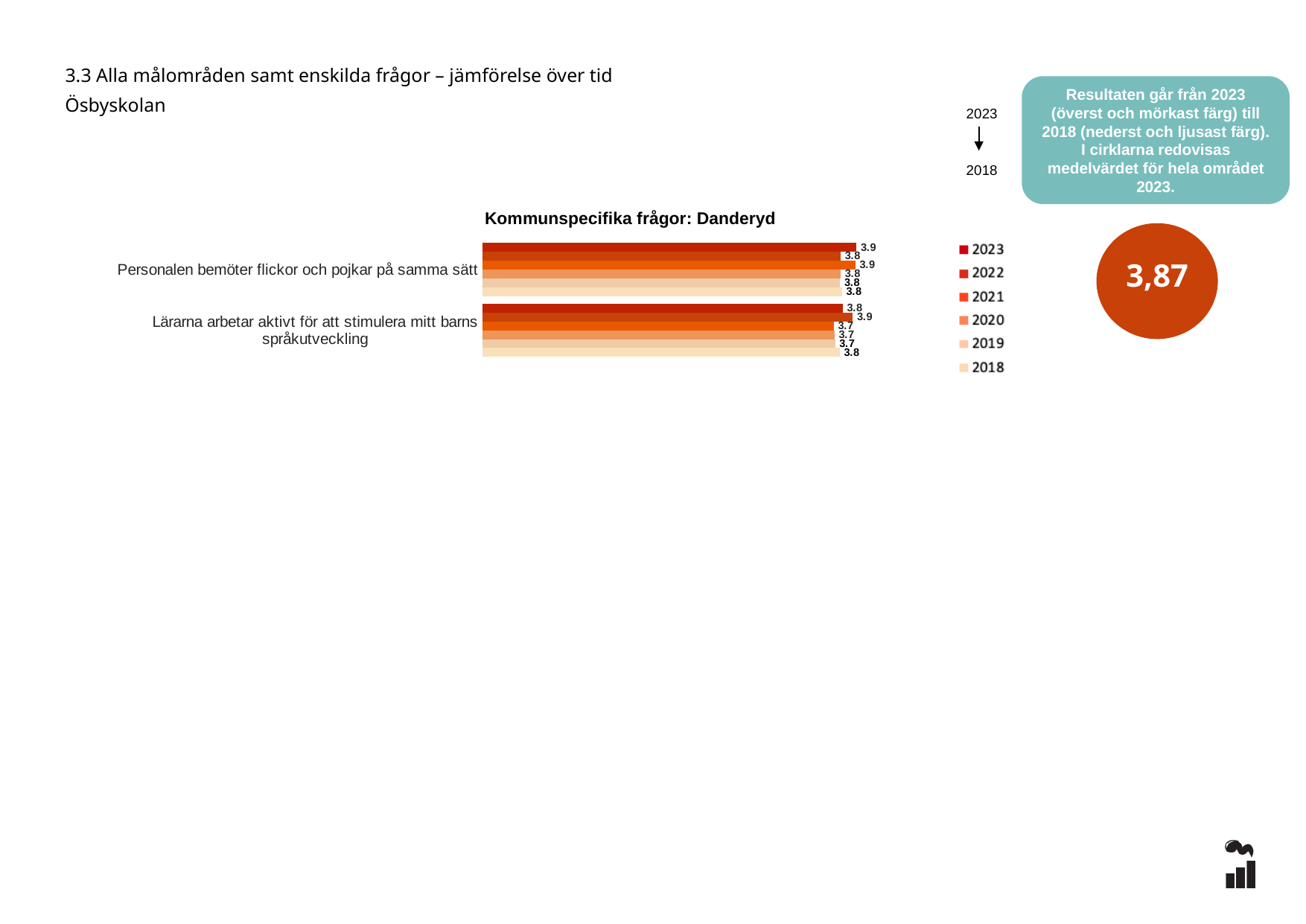
What kind of chart is shown on the slide? bar chart How many categories (questions) are plotted in the chart? 2 What is the 2023 value for 'Lärarna arbetar aktivt för att stimulera mitt barns språkutveckling'? 3.8 What is the title of the chart? Kommunspecifika frågor: Danderyd What is the difference between the 2022 and 2021 values for 'Lärarna arbetar aktivt för att stimulera mitt barns språkutveckling'? 0.2 What is the 2018 value for 'Personalen bemöter flickor och pojkar på samma sätt'? 3.8 What mean value for the whole area in 2023 is shown in the circle next to the chart? 3,87 What is the 2021 value for 'Lärarna arbetar aktivt för att stimulera mitt barns språkutveckling'? 3.7 What is the 2022 value for 'Lärarna arbetar aktivt för att stimulera mitt barns språkutveckling'? 3.9 Which year has the lowest value for 'Personalen bemöter flickor och pojkar på samma sätt' among 2023, 2022 and 2021? 2022 What is the 2023 value for 'Personalen bemöter flickor och pojkar på samma sätt'? 3.9 How many series does the legend list? 6